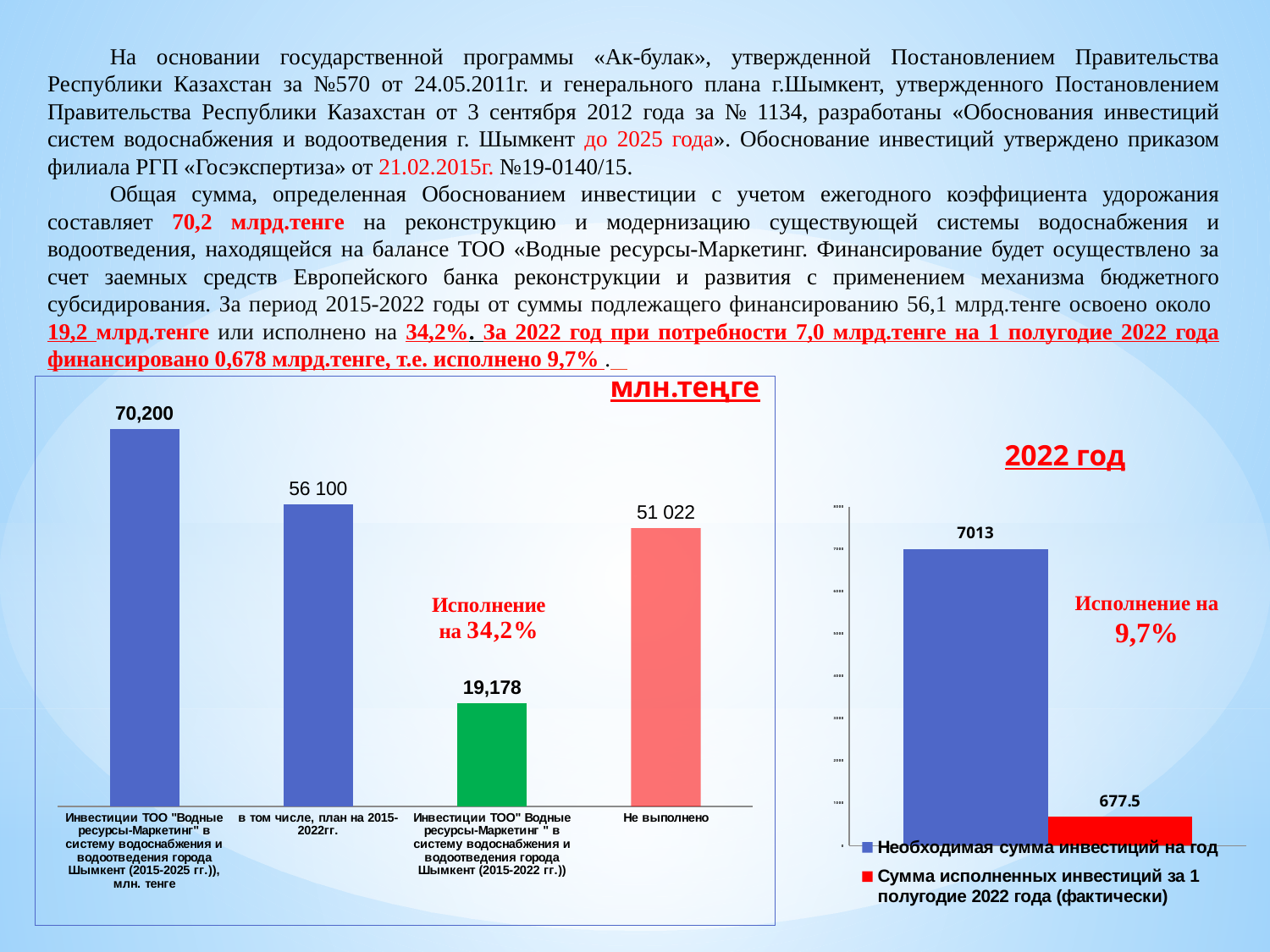
In the "2022 год" chart, what colour is the bar for "Сумма исполненных инвестиций за 1 полугодие 2022 года (фактически)"? Red In the left chart, which is larger: the bar for "в том числе, план на 2015-2022гг." or the bar for "Не выполнено"? в том числе, план на 2015-2022гг. In the "2022 год" chart, what is the value of "Необходимая сумма инвестиций на год"? 7013 In the "2022 год" chart, what is the value of "Сумма исполненных инвестиций за 1 полугодие 2022 года (фактически)"? 677.5 In the left chart, what is the value of the bar for "в том числе, план на 2015-2022гг."? 56 100 In the left chart, what is the value of the bar labelled "Не выполнено"? 51 022 In the left chart, how many bars are plotted? 4 In the left chart, which bar has the highest value? Инвестиции ТОО "Водные ресурсы-Маркетинг" в систему водоснабжения и водоотведения города Шымкент (2015-2025 гг.)), млн. тенге In the left chart, which bar has the lowest value? Инвестиции ТОО" Водные ресурсы-Маркетинг " в систему водоснабжения и водоотведения города Шымкент (2015-2022 гг.)) How many series does the legend of the "2022 год" chart list? 2 In the left chart, what is the value of the green bar? 19,178 What type of chart is the left chart? Bar chart